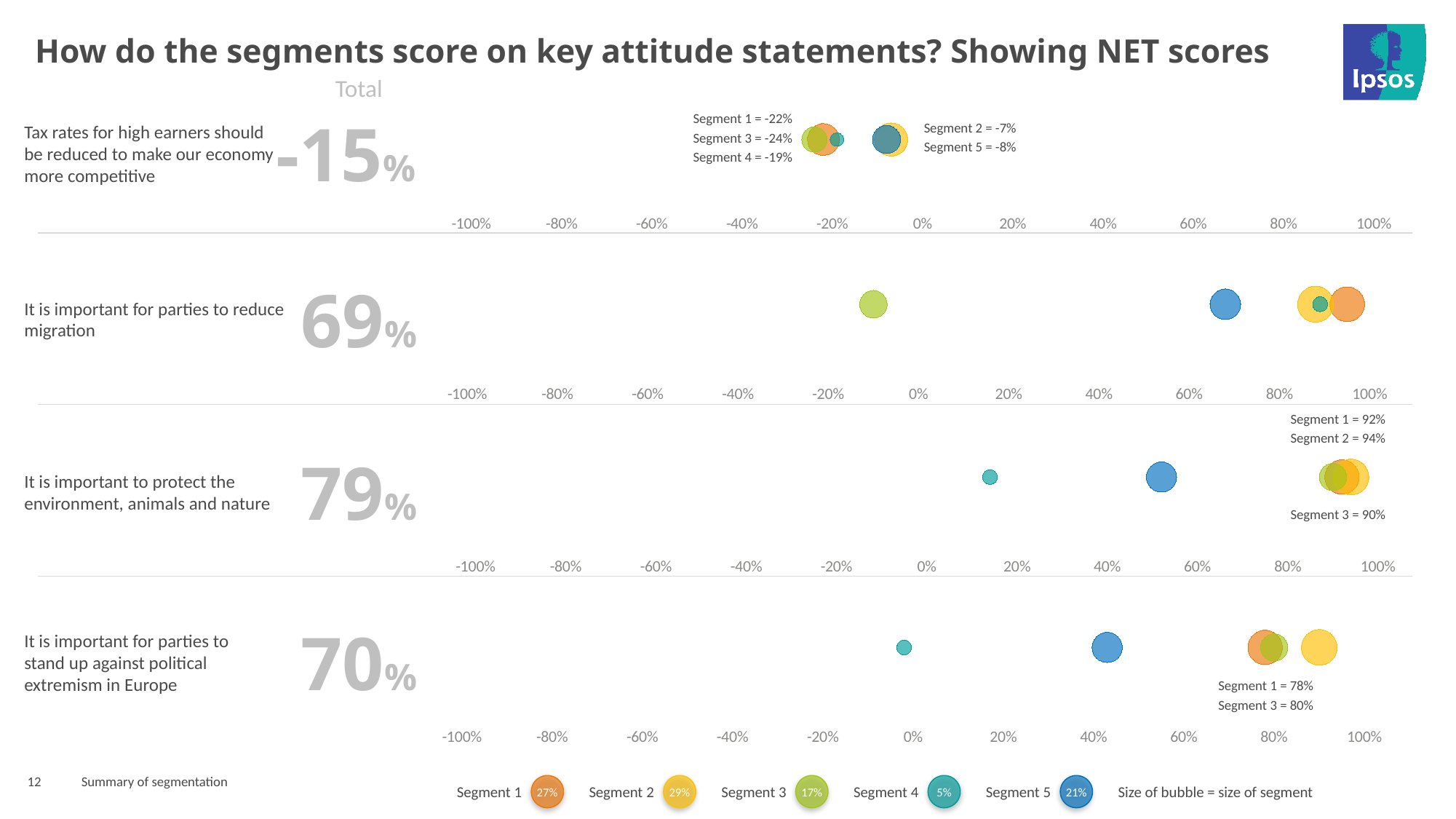
According to the legend, what does the size of a bubble represent? Size of segment On the chart for 'It is important to protect the environment, animals and nature', is the value for Segment 5 greater or less than 40%? greater What is the Total NET score for 'It is important for parties to reduce migration'? 69% On the chart for 'Tax rates for high earners should be reduced to make our economy more competitive', what is the NET score for Segment 3? -24% How many segments does the legend at the bottom of the slide list? 5 On the chart for 'It is important for parties to stand up against political extremism in Europe', which is larger, the score for Segment 1 or Segment 3? Segment 3 What is the Total NET score for 'It is important to protect the environment, animals and nature'? 79% On the chart for 'It is important to protect the environment, animals and nature', what is the NET score for Segment 2? 94% On the chart for 'Tax rates for high earners should be reduced to make our economy more competitive', which segment has the highest NET score? Segment 2 On the chart for 'Tax rates for high earners should be reduced to make our economy more competitive', which segment has the lowest NET score? Segment 3 On the chart for 'It is important to protect the environment, animals and nature', what is the difference between the Segment 2 and Segment 3 scores? 4 percentage points On the chart for 'It is important for parties to reduce migration', is the value for Segment 5 greater or less than 60%? greater